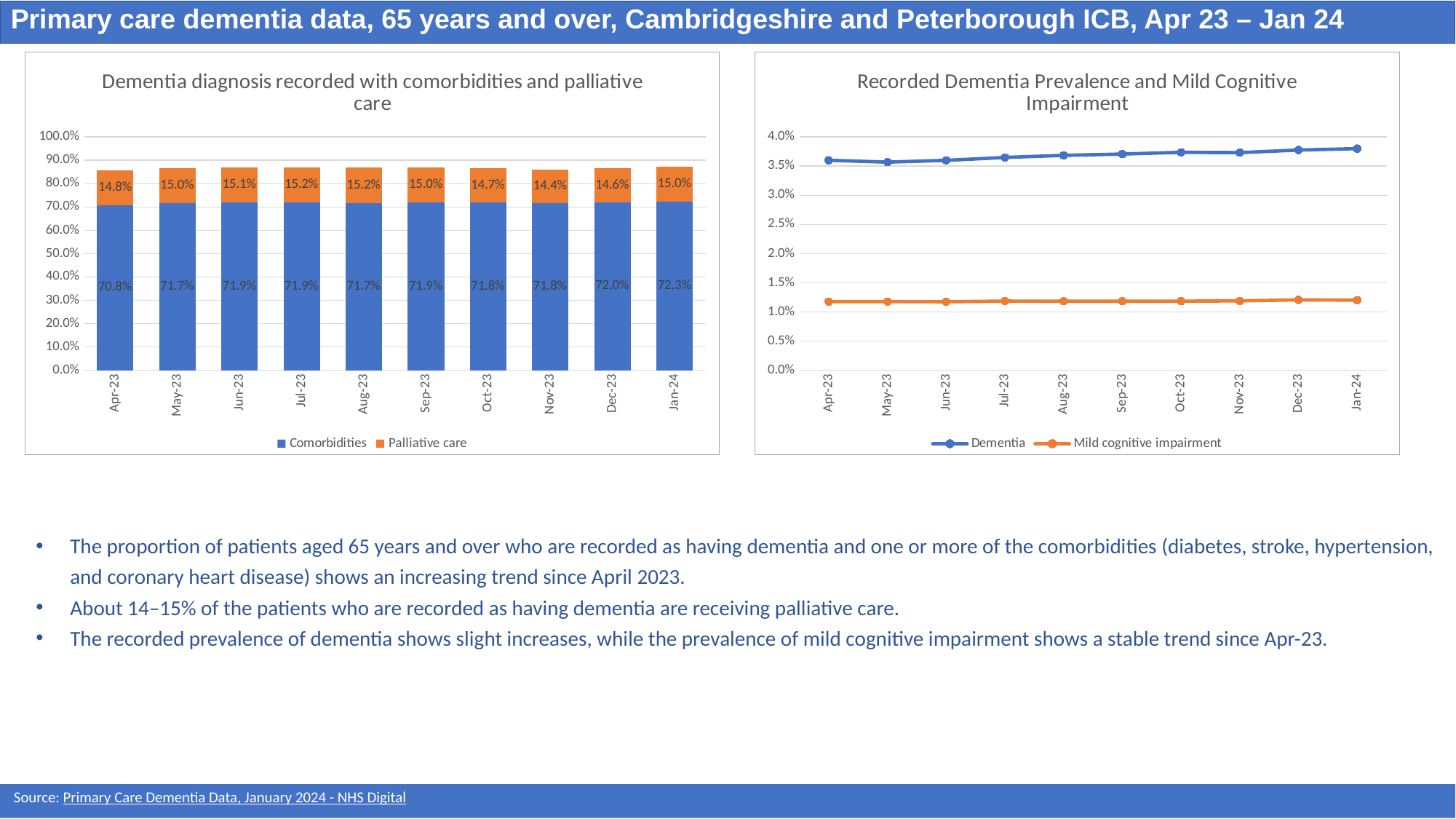
How many months are shown on the x axis of the 'Dementia diagnosis recorded with comorbidities and palliative care' chart? 10 In the 'Dementia diagnosis recorded with comorbidities and palliative care' chart, by how much does the Comorbidities value for Jan-24 exceed that for Apr-23? 1.5 percentage points In the 'Dementia diagnosis recorded with comorbidities and palliative care' chart, what is the total of the stacked bar for Jan-24? 87.3% In the 'Recorded Dementia Prevalence and Mild Cognitive Impairment' chart, does the Dementia line rise or fall from Apr-23 to Jan-24? Rise In the 'Recorded Dementia Prevalence and Mild Cognitive Impairment' chart, is the Mild cognitive impairment value for Apr-23 greater or less than 1.5%? less In the 'Dementia diagnosis recorded with comorbidities and palliative care' chart, which month has the lowest Palliative care value? Nov-23 How many series does the legend of the 'Recorded Dementia Prevalence and Mild Cognitive Impairment' chart list? 2 In the 'Dementia diagnosis recorded with comorbidities and palliative care' chart, what is the Palliative care value for Nov-23? 14.4% In the 'Dementia diagnosis recorded with comorbidities and palliative care' chart, is the Palliative care value larger for Jul-23 or Oct-23? Jul-23 What kind of chart is the 'Recorded Dementia Prevalence and Mild Cognitive Impairment' chart? Line chart In the 'Dementia diagnosis recorded with comorbidities and palliative care' chart, what is the Comorbidities value for Apr-23? 70.8% In the 'Dementia diagnosis recorded with comorbidities and palliative care' chart, which month has the highest Comorbidities value? Jan-24